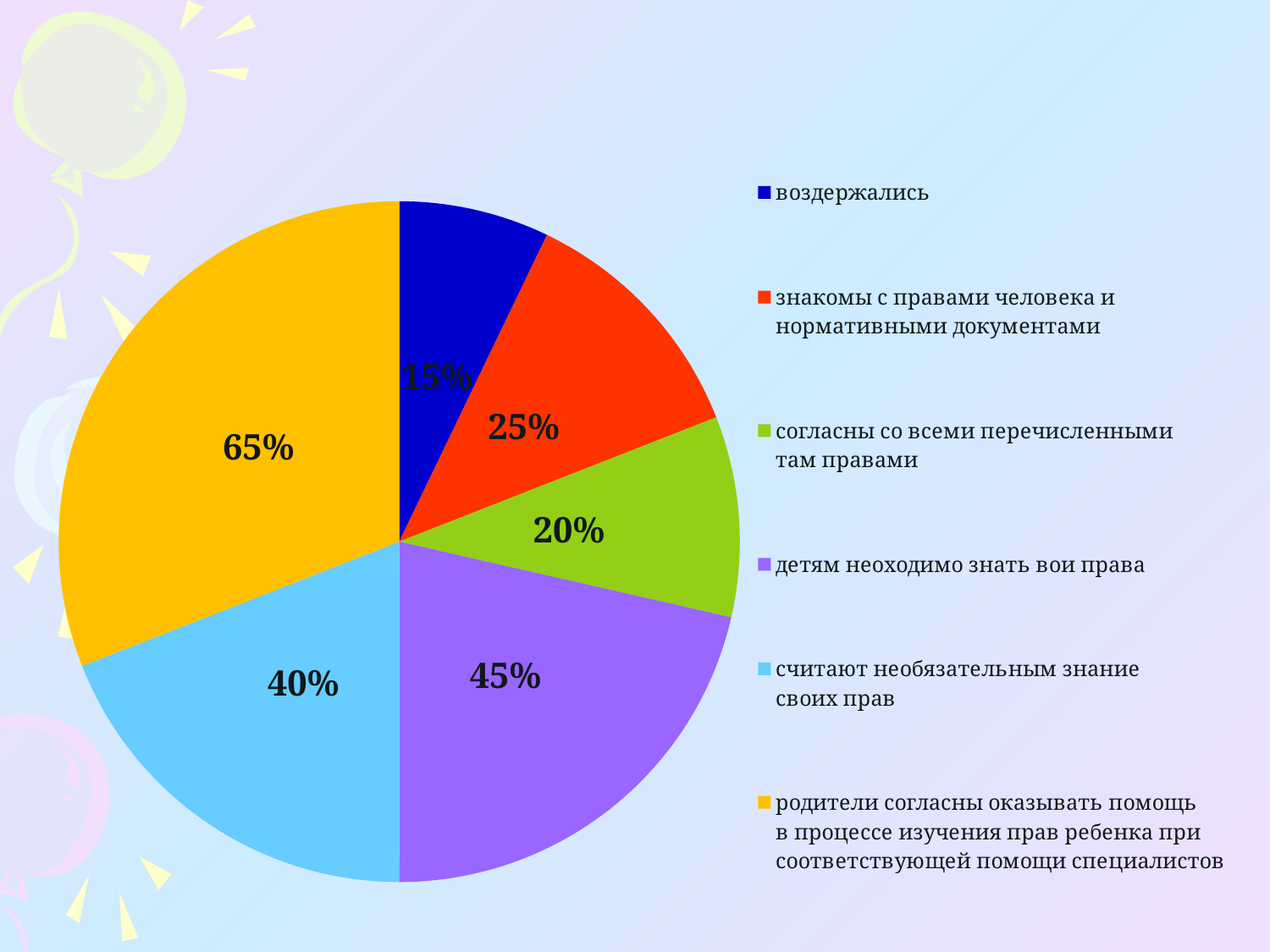
What kind of chart is shown on the slide? pie chart What value is shown for the slice "воздержались"? 15% What value is shown for the slice "знакомы с правами человека и нормативными документами"? 25% What colour is the slice for "воздержались"? dark blue Which category has the largest slice of the pie? родители согласны оказывать помощь в процессе изучения прав ребенка при соответствующей помощи специалистов Which category has the smallest slice of the pie? воздержались What value is shown for the slice "считают необязательным знание своих прав"? 40% How many entries does the legend list? 6 What is the difference between the values for "детям неоходимо знать вои права" and "считают необязательным знание своих прав"? 5% What value is shown for the slice "согласны со всеми перечисленными там правами"? 20% What value is shown for the slice "детям неоходимо знать вои права"? 45% How many slices does the pie chart have? 6